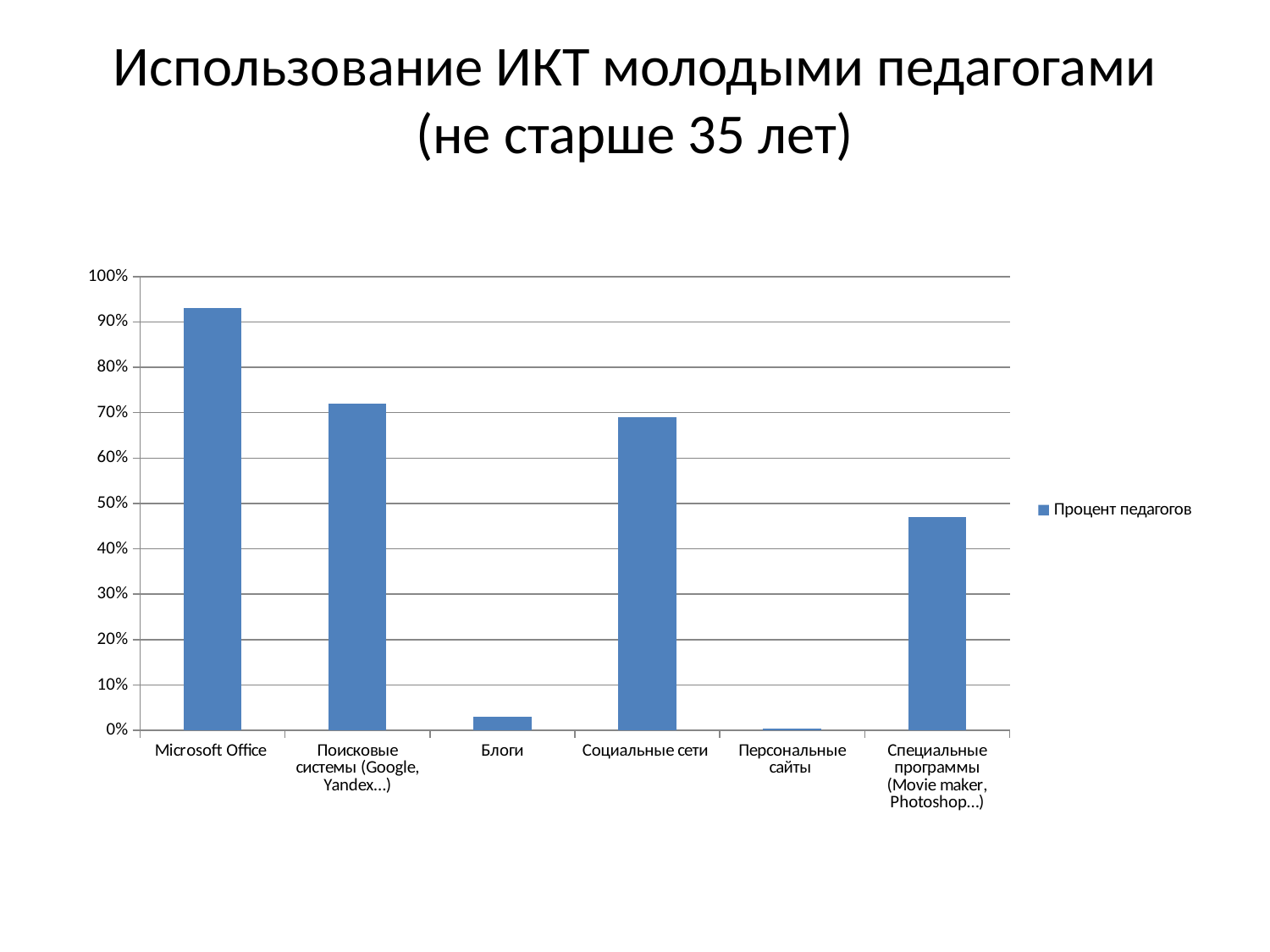
How many categories are shown on the x axis of the chart? 6 What is the name of the series shown in the legend? Процент педагогов Which category has the highest value? Microsoft Office Is the value for Социальные сети greater or less than 60%? greater Is the value for Блоги greater or less than 10%? less Is the value for Специальные программы (Movie maker, Photoshop…) greater or less than 50%? less Which is larger, the value for Специальные программы (Movie maker, Photoshop…) or the value for Блоги? Специальные программы (Movie maker, Photoshop…) Which category has the lowest value? Персональные сайты What kind of chart is shown on the slide? bar chart How many series does the legend list? 1 Which is larger, the value for Microsoft Office or the value for Социальные сети? Microsoft Office